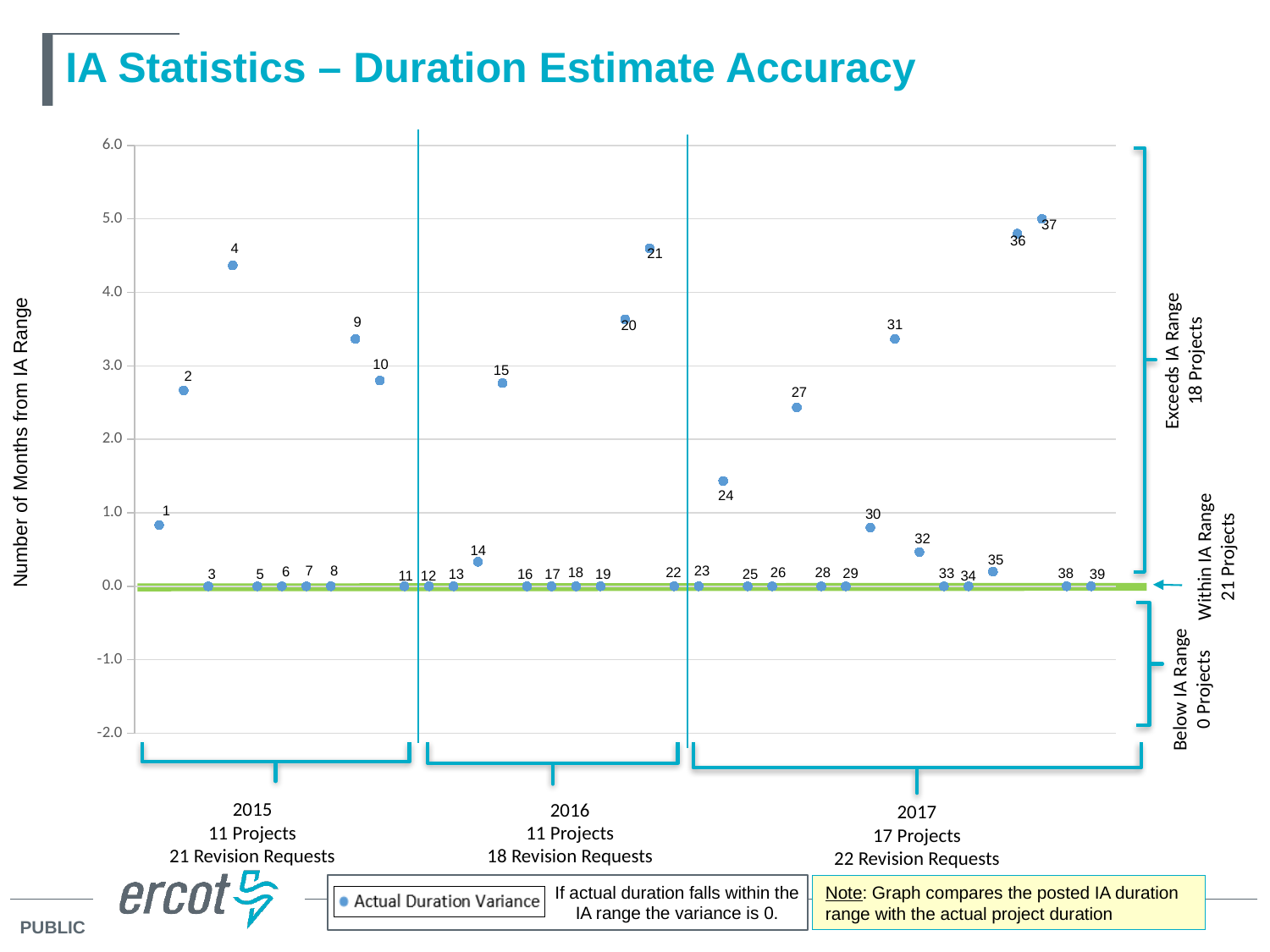
How many series does the chart legend list? 1 What is the label of the chart's vertical axis? Number of Months from IA Range Is the value for point 1 greater or less than 1.0? less What series name is shown in the chart legend? Actual Duration Variance Is the value for point 4 greater or less than 4.0? greater Which has the larger value, point 9 or point 10? point 9 Is the value for point 37 greater or less than 4.0? greater Which has the larger value, point 24 or point 30? point 24 What kind of chart is shown on the slide? scatter chart How many data points are plotted in the chart? 39